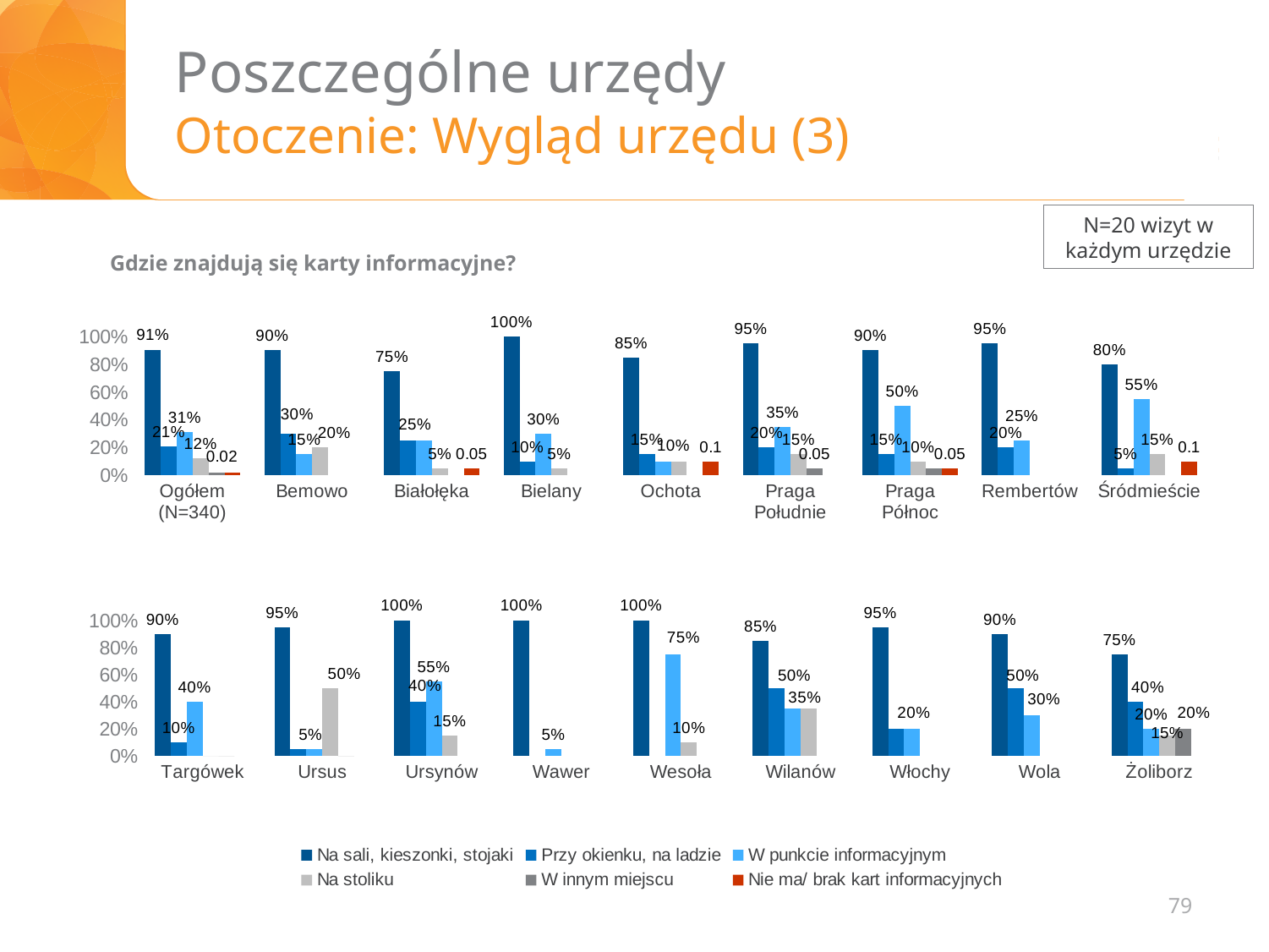
In the bottom chart, what is the value of 'Na stoliku' for Ursus? 50% In the top chart, how many categories (offices) are shown on the x axis? 9 What question is posed as the heading above the charts? Gdzie znajdują się karty informacyjne? What kind of chart is used on this slide to show where information cards are located? Bar chart In the top chart, which office has the lowest value for 'Na sali, kieszonki, stojaki'? Białołęka In the top chart, what is the difference between the 'Na sali, kieszonki, stojaki' values for Rembertów and Śródmieście? 15 percentage points In the bottom chart, which office has the lowest value for 'Na sali, kieszonki, stojaki'? Żoliborz In the bottom chart, which has the larger 'W punkcie informacyjnym' value: Wesoła or Targówek? Wesoła In the top chart, what is the value of 'W punkcie informacyjnym' for Śródmieście? 55% In the top chart, which office has the highest value for 'Na sali, kieszonki, stojaki'? Bielany How many series does the legend list? 6 In the top chart, what is the value of 'Na sali, kieszonki, stojaki' for Bielany? 100%